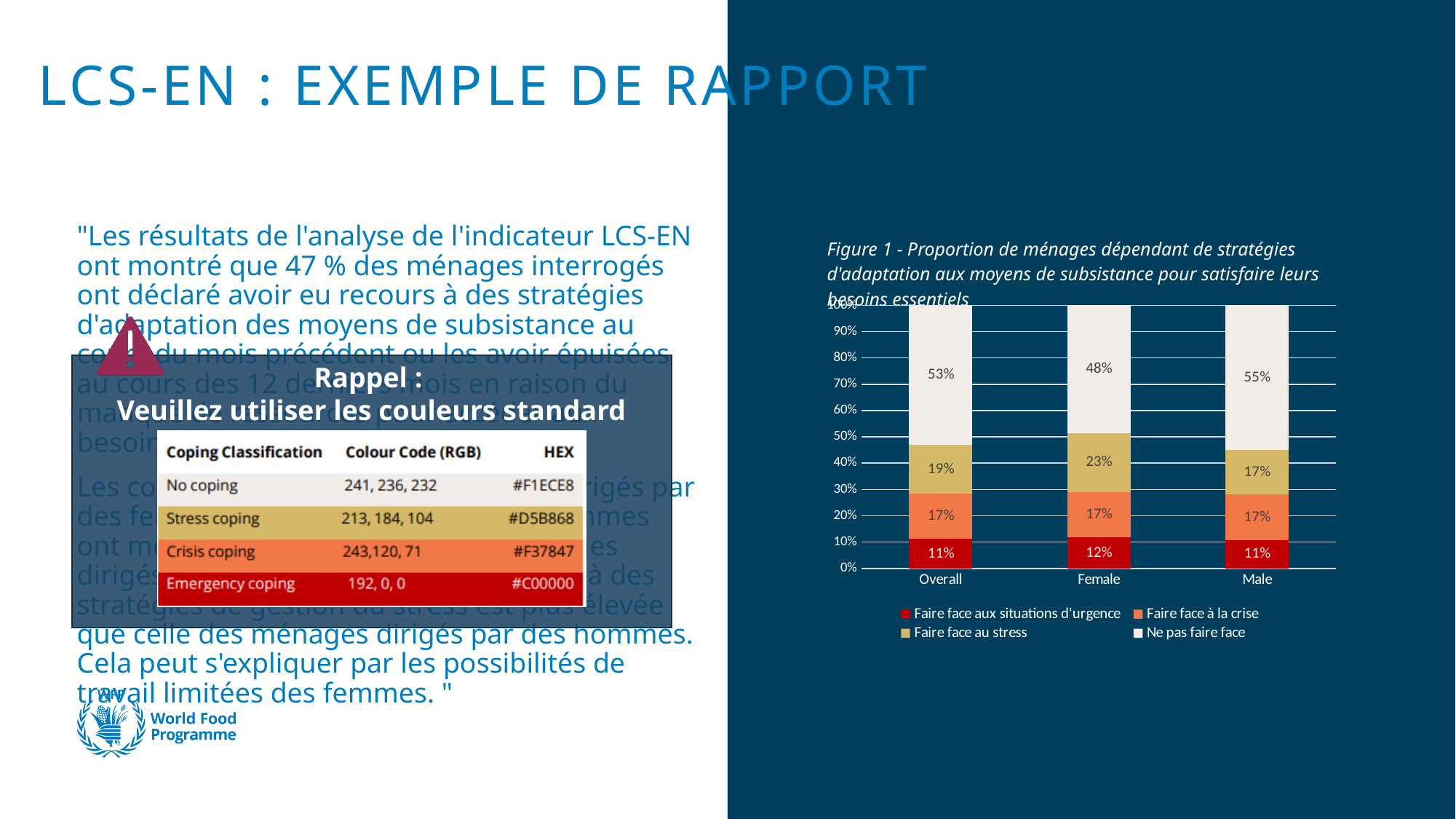
Which series is shown in red in the chart? Faire face aux situations d'urgence Which category has the lowest value for "Faire face au stress"? Male What kind of chart is shown on the slide? stacked bar chart How many series does the chart legend list? 4 What is the difference between the "Faire face au stress" values for Female and Male? 6% Is the "Ne pas faire face" value larger for Overall or for Female? Overall What is the value of "Faire face au stress" for Female? 23% How many categories are shown on the x axis of the chart? 3 What is the value of "Faire face aux situations d'urgence" for Male? 11% Which category has the highest value for "Ne pas faire face"? Male What is the value of "Ne pas faire face" for Female? 48% What is the value of "Faire face à la crise" for Overall? 17%